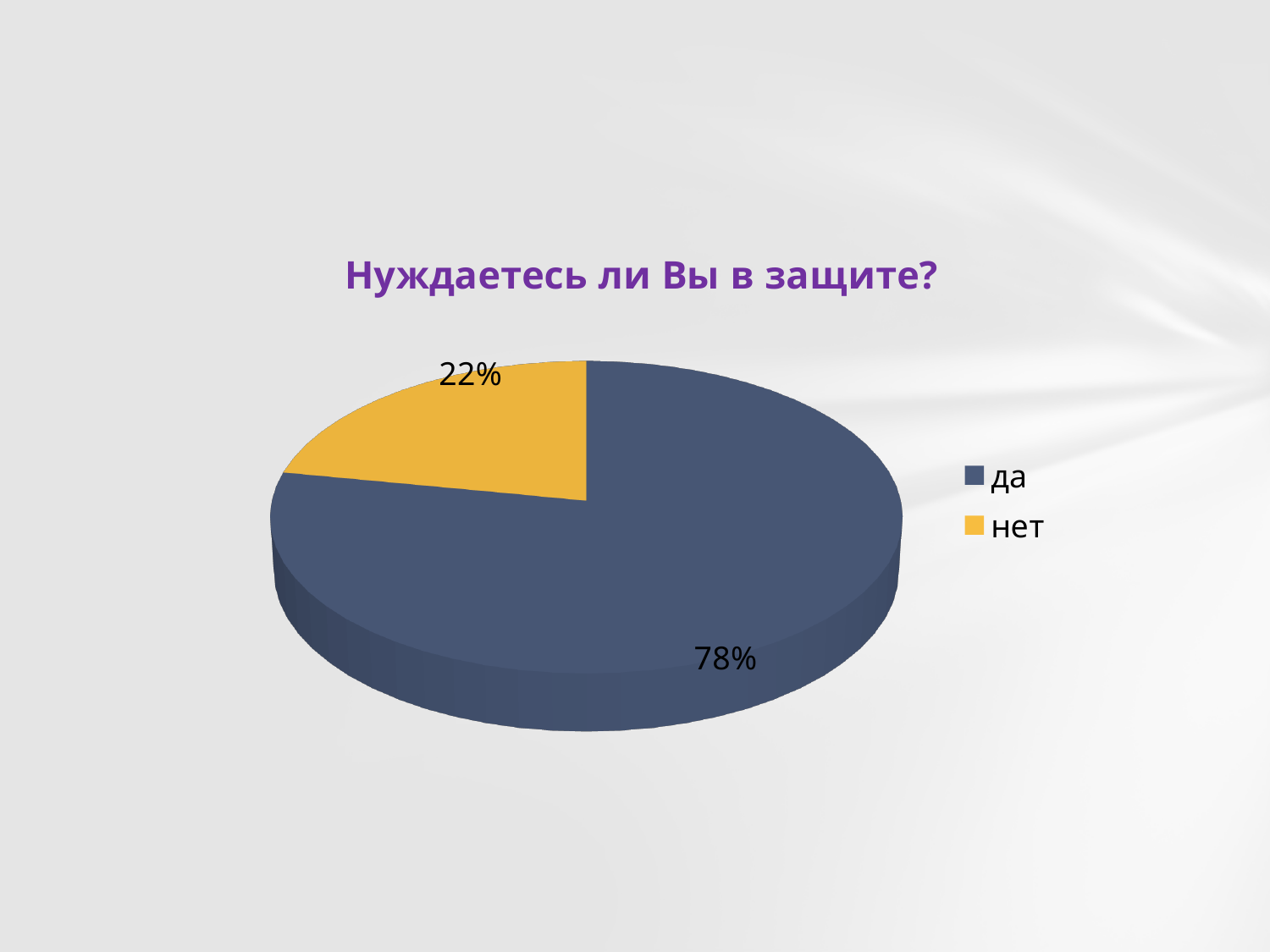
What share of the pie does the "да" slice represent? 78% What colour is the "нет" slice? yellow What is the total of the two slices shown? 100% What type of chart is shown on the slide? pie chart What is the title of the chart? Нуждаетесь ли Вы в защите? How many entries does the legend list? 2 Which category has the smallest slice of the pie? нет Which is larger, the "да" slice or the "нет" slice? да What share of the pie does the "нет" slice represent? 22% How many categories does the pie chart show? 2 What is the difference in percentage points between the "да" and "нет" slices? 56% Which category has the largest slice of the pie? да